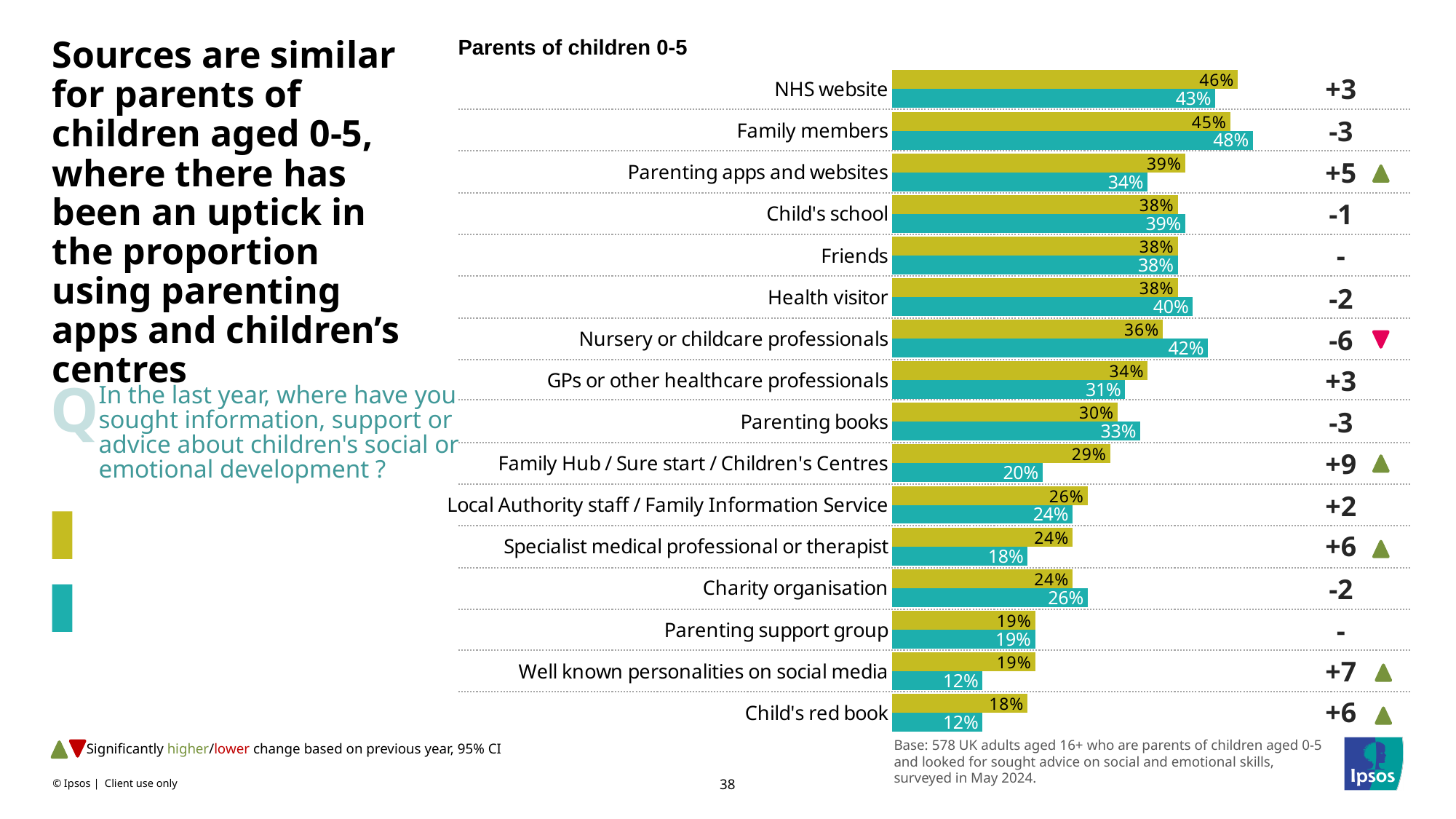
For Nursery or childcare professionals, which is larger, the yellow bar or the teal bar? The teal bar What is the value of the teal bar for Well known personalities on social media? 12% What change figure is shown to the right of the bars for Family Hub / Sure start / Children's Centres? +9 What type of chart is shown on the slide? Bar chart Which category has the highest yellow bar? NHS website How many series does the chart show? 2 Which category has the lowest yellow bar? Child's red book What is the difference between the yellow bar and the teal bar for Family Hub / Sure start / Children's Centres? 9 percentage points What is the value of the teal bar for Family members? 48% How many categories are shown in the chart? 16 What is the value of the yellow bar for NHS website? 46% Which category has the highest teal bar? Family members